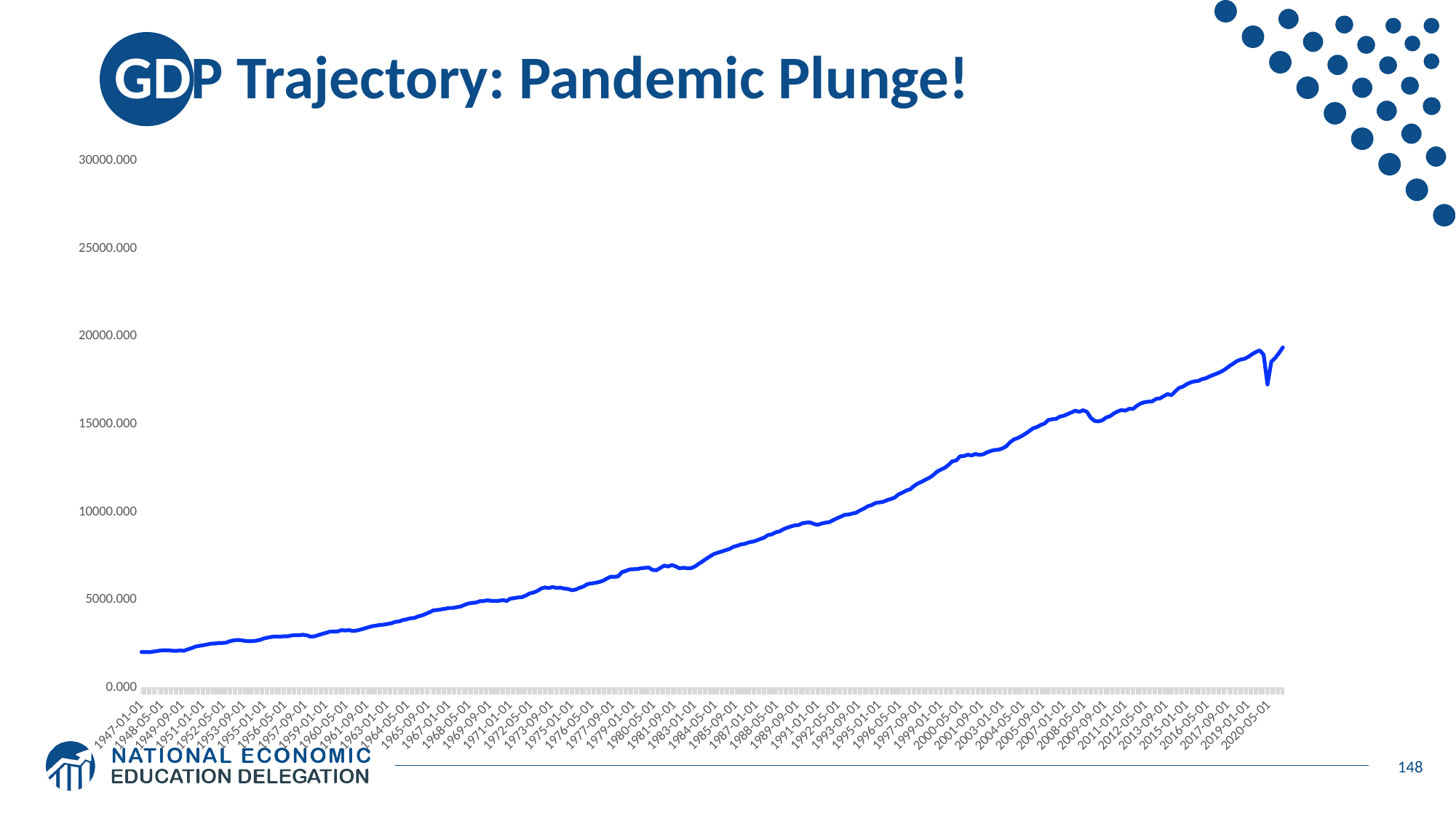
Is the value for 1947-01-01 greater or less than 5000.000? less Which is larger, the value for 1975-01-01 or the value for 2015-01-01? 2015-01-01 Does the line ever reach the 20000.000 level on the y axis? no Is the value for 2020-05-01 greater or less than 15000.000? greater What is the title of the slide's chart? GDP Trajectory: Pandemic Plunge! What kind of chart is shown on the slide? line chart What is the highest tick label shown on the y axis? 30000.000 Overall, do the values rise or fall along the x axis from 1947 to 2020? rise